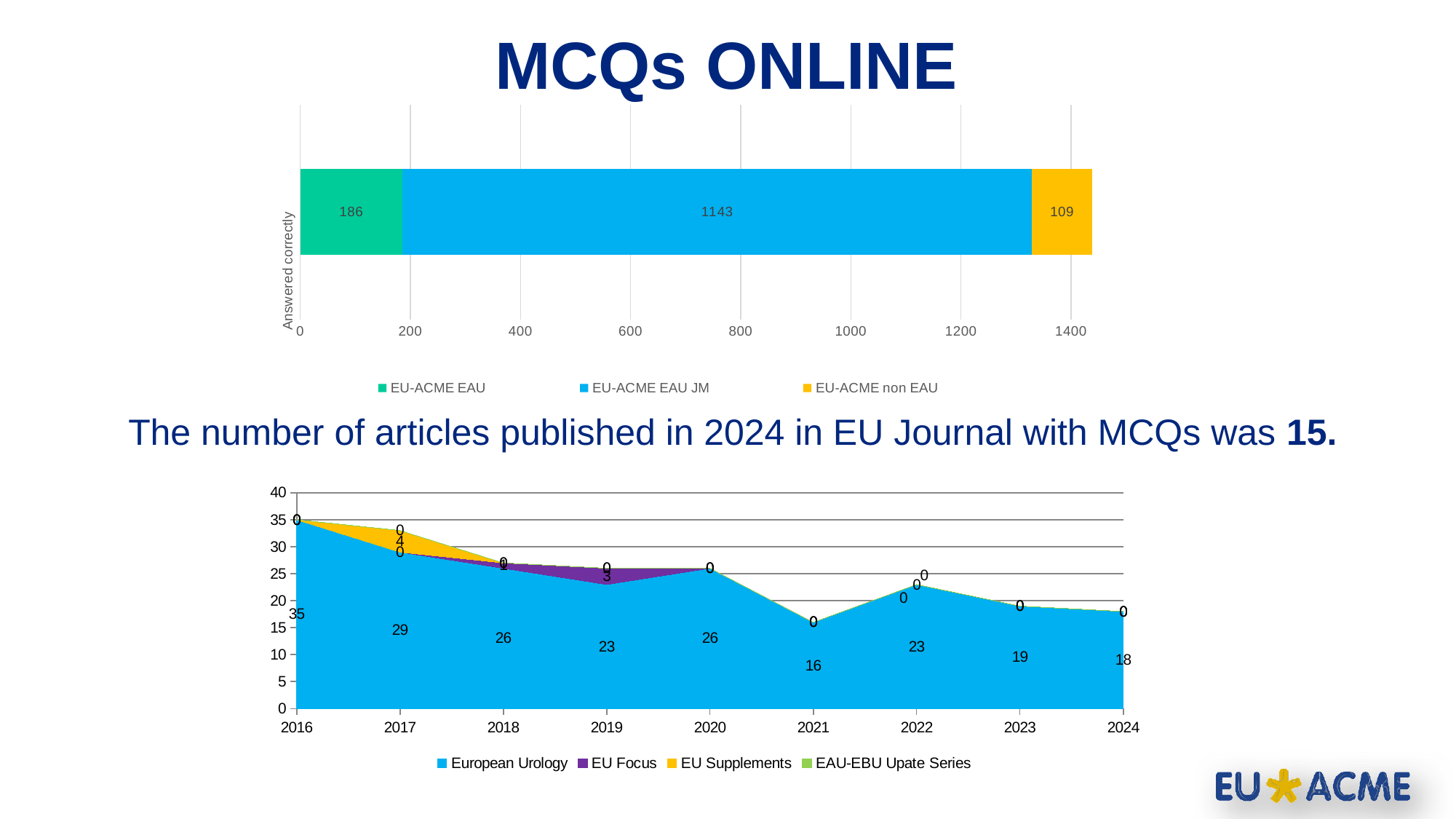
In the bottom area chart, is the European Urology value for 2020 larger or smaller than the value for 2021? Larger In the top bar chart, what is the value for EU-ACME non EAU? 109 In the bottom area chart, what is the European Urology value for 2021? 16 In the top bar chart, what is the difference between the EU-ACME EAU value and the EU-ACME non EAU value? 77 In the bottom area chart, which year has the highest European Urology value? 2016 In the bottom area chart, how many years are shown on the x axis? 9 How many series does the legend of the top chart list? 3 In the top bar chart, what is the total of the stacked bar? 1438 In the top bar chart, what is the value for EU-ACME EAU JM? 1143 In the top bar chart, which series has the smallest value? EU-ACME non EAU In the bottom area chart, what is the EU Focus value for 2019? 3 What kind of chart is the top chart? Bar chart